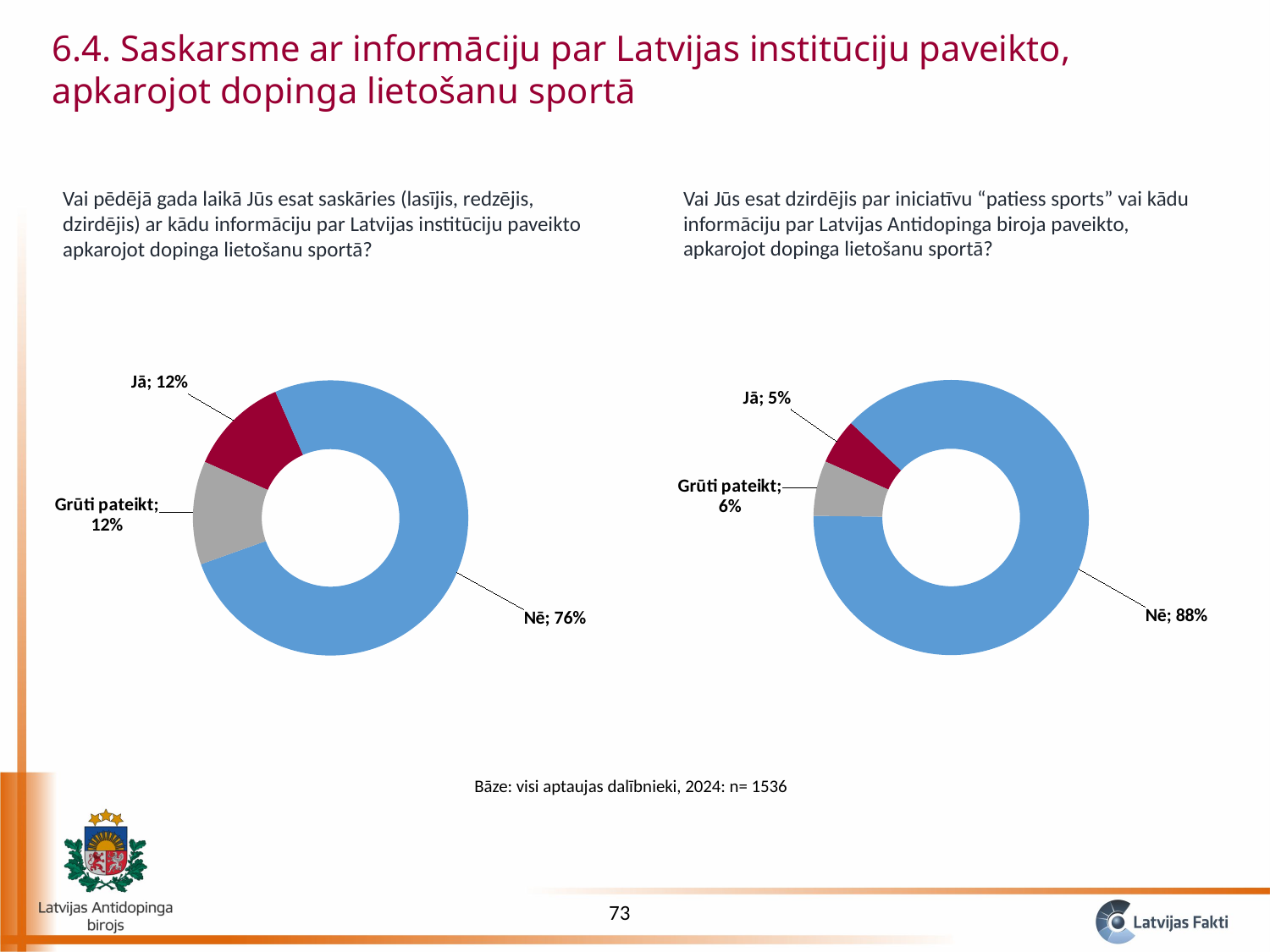
How many categories does the right chart show? 3 In the right chart, what share of respondents answered "Jā"? 5% What type of chart is the left chart? doughnut (pie) chart In the right chart, what share of respondents answered "Grūti pateikt"? 6% In the left chart, which answer has the largest share? Nē In the left chart, what share of respondents answered "Grūti pateikt"? 12% In the right chart, what share of respondents answered "Nē"? 88% In the left chart, what share of respondents answered "Nē"? 76% In the left chart, what share of respondents answered "Jā"? 12% In the left chart, what is the difference in percentage points between "Nē" and "Jā"? 64 In the right chart, which answer has the smallest share? Jā Which chart has the larger share for "Nē", the left chart or the right chart? the right chart